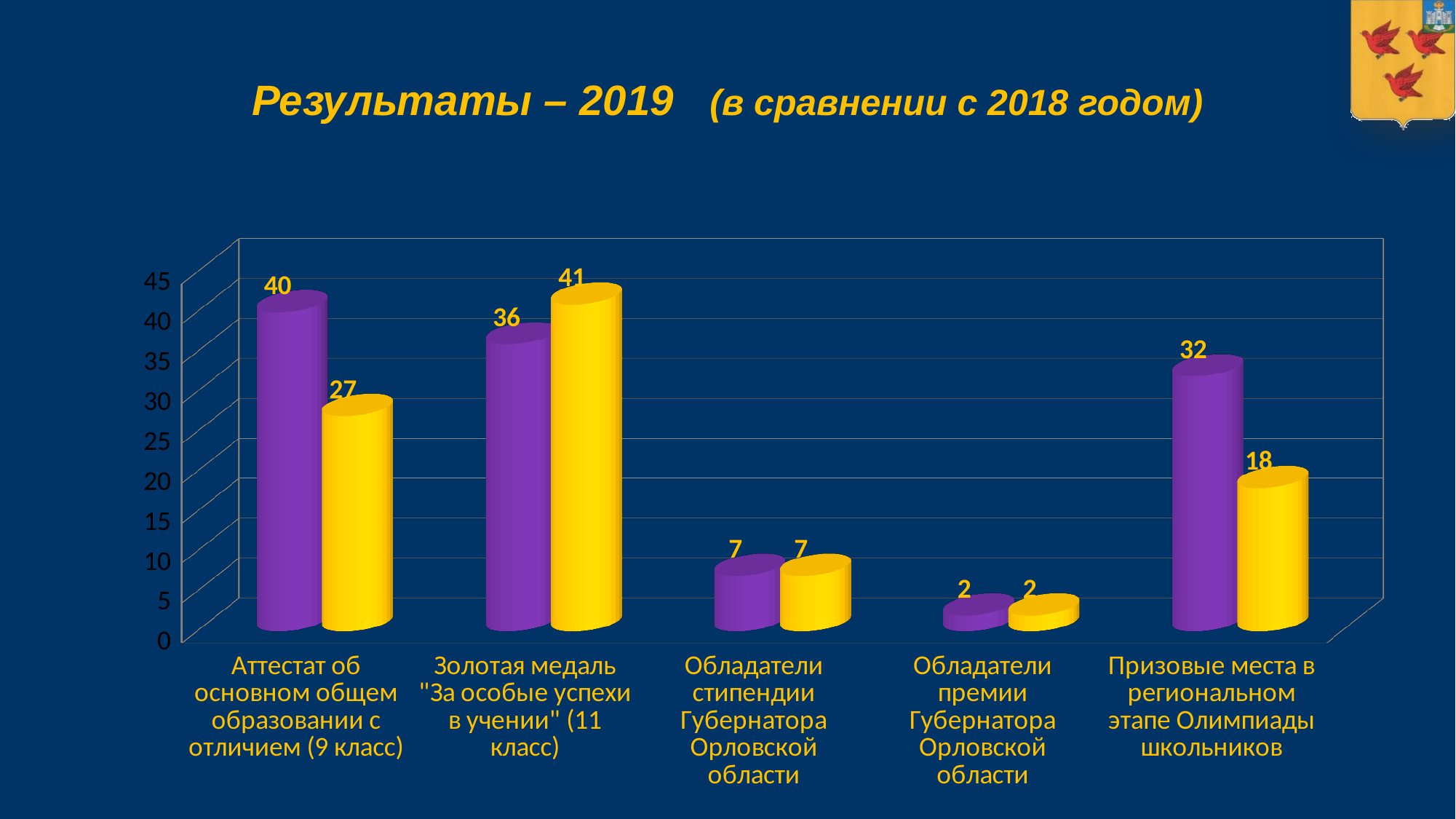
What kind of chart is shown on the slide? bar chart What is the value of the purple bar for "Аттестат об основном общем образовании с отличием (9 класс)"? 40 Which category has the highest yellow bar? Золотая медаль "За особые успехи в учении" (11 класс) What is the title of the slide? Результаты – 2019 (в сравнении с 2018 годом) Which category has the lowest purple bar? Обладатели премии Губернатора Орловской области For "Золотая медаль "За особые успехи в учении" (11 класс)", which bar is larger, purple or yellow? yellow What is the value of the yellow bar for "Золотая медаль "За особые успехи в учении" (11 класс)"? 41 What is the difference between the purple and yellow bars for "Призовые места в региональном этапе Олимпиады школьников"? 14 How many categories are shown on the x axis? 5 What is the value of the yellow bar for "Аттестат об основном общем образовании с отличием (9 класс)"? 27 What is the difference between the purple and yellow bars for "Аттестат об основном общем образовании с отличием (9 класс)"? 13 What is the value of the purple bar for "Призовые места в региональном этапе Олимпиады школьников"? 32